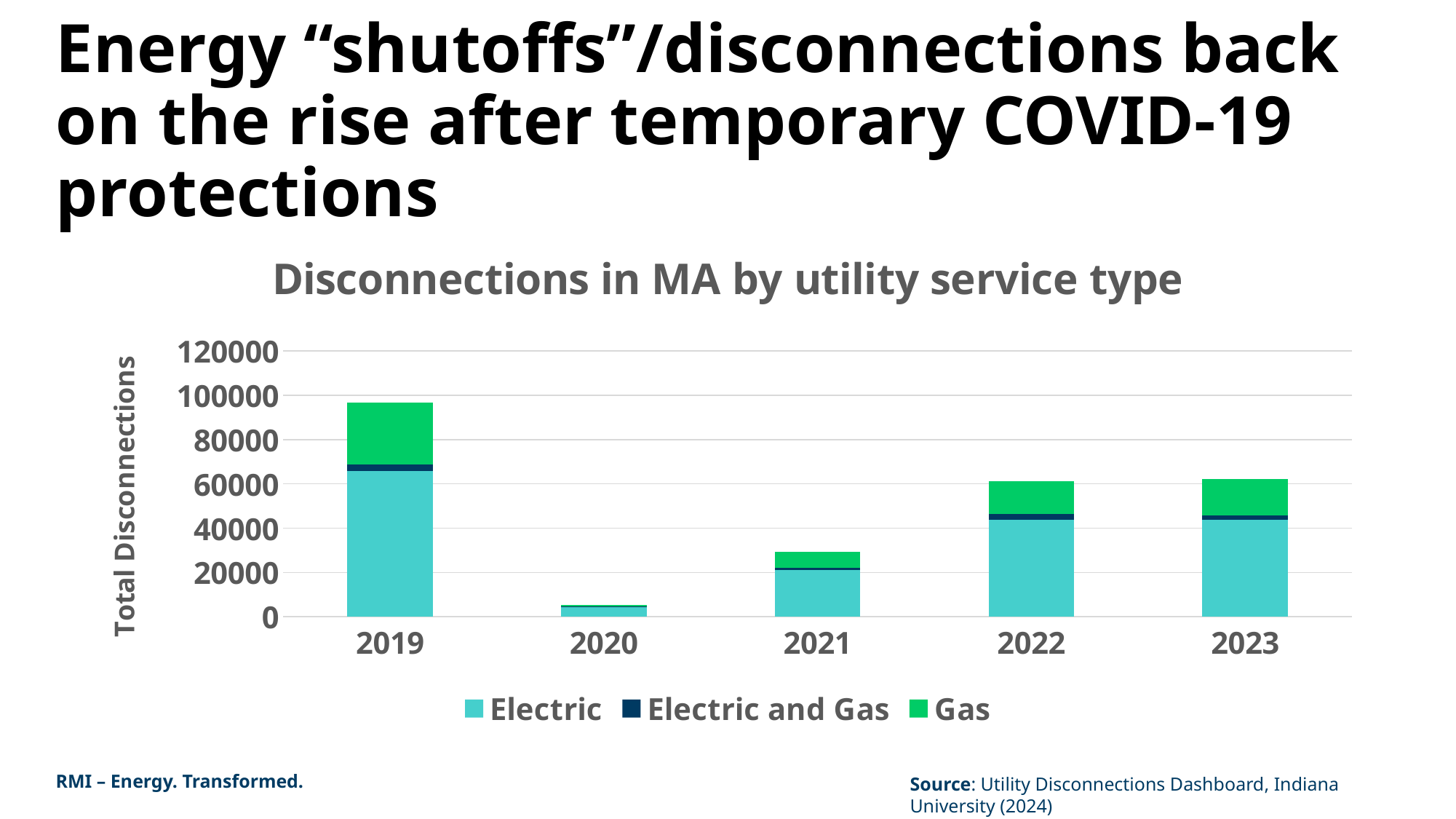
How many series does the chart's legend list? 3 Is the total disconnections value for 2022 greater or less than 40000? greater What kind of chart is shown on the slide? Stacked bar chart Which year has more total disconnections, 2019 or 2021? 2019 How many years are shown on the x axis of the chart? 5 Is the total disconnections value for 2019 greater or less than 80000? greater Is the Electric value for 2023 greater or less than 60000? less What is the title of the chart? Disconnections in MA by utility service type Which year has the lowest total disconnections? 2020 Which year has the highest total disconnections? 2019 Do total disconnections rise or fall from 2020 to 2022? Rise